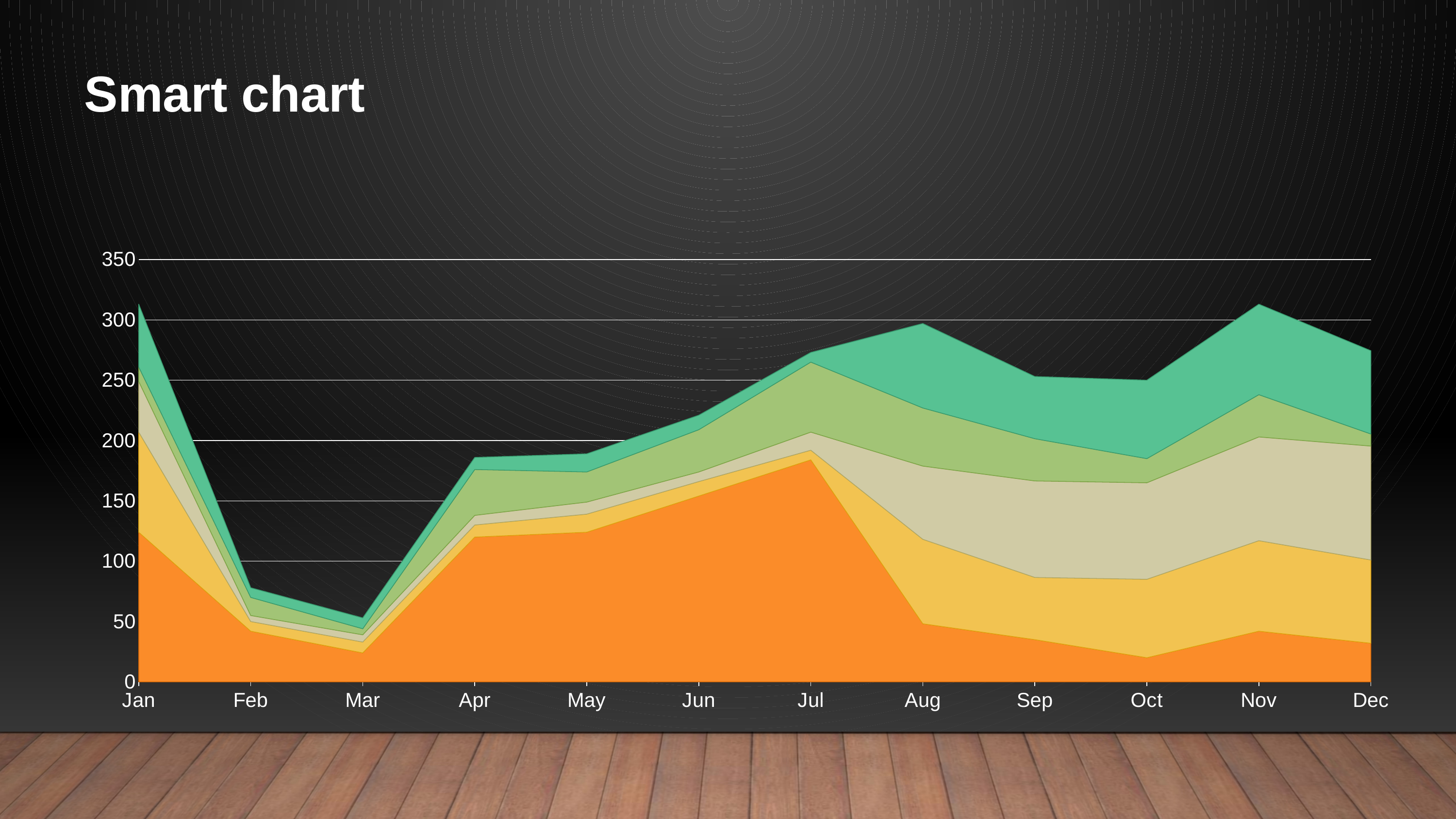
How many coloured bands (series) are stacked in the chart? 5 What kind of chart is shown on the slide? Stacked area chart How many months are shown along the x axis? 12 Is the stacked total for Jan greater or less than 300? greater Does the stacked total rise or fall from Feb to Jul? rise Which has the larger stacked total, Jul or Mar? Jul Is the value of the bottom orange series for Oct greater or less than 50? less What is the title of the slide? Smart chart Is the value of the bottom orange series for Jul greater or less than 150? greater Which month has the lowest stacked total? Mar